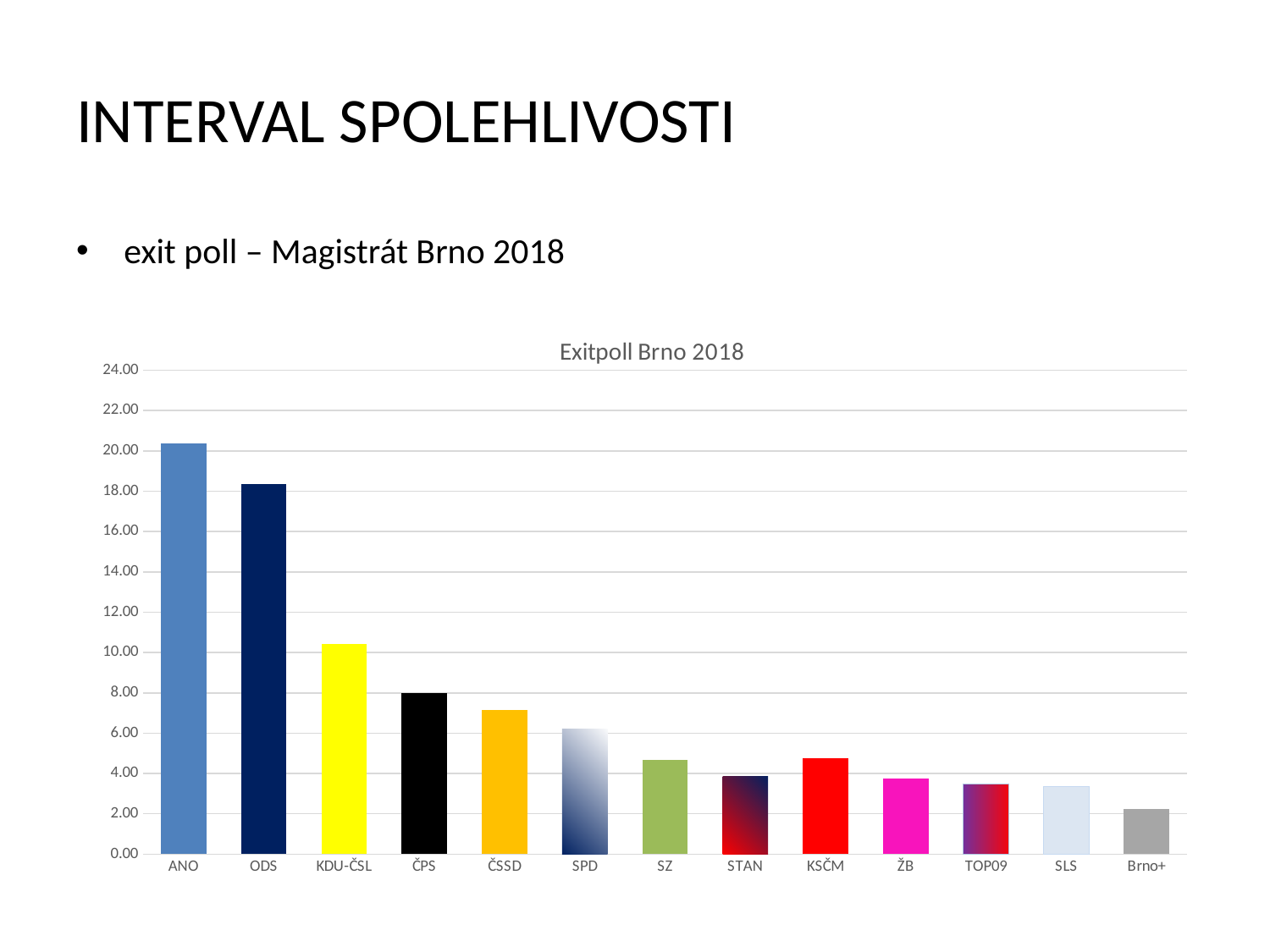
Which has the larger value, ČSSD or SPD? ČSSD Which party has the highest value in the chart? ANO How many parties (categories) are shown on the x axis of the chart? 13 Is the value for ODS greater or less than 16.00? greater What kind of chart is shown on the slide? bar chart Is the value for ANO greater or less than 18.00? greater What is the title of the chart? Exitpoll Brno 2018 Is the value for SPD greater or less than 4.00? greater Which party has the lowest value in the chart? Brno+ Which has the larger value, ANO or ODS? ANO